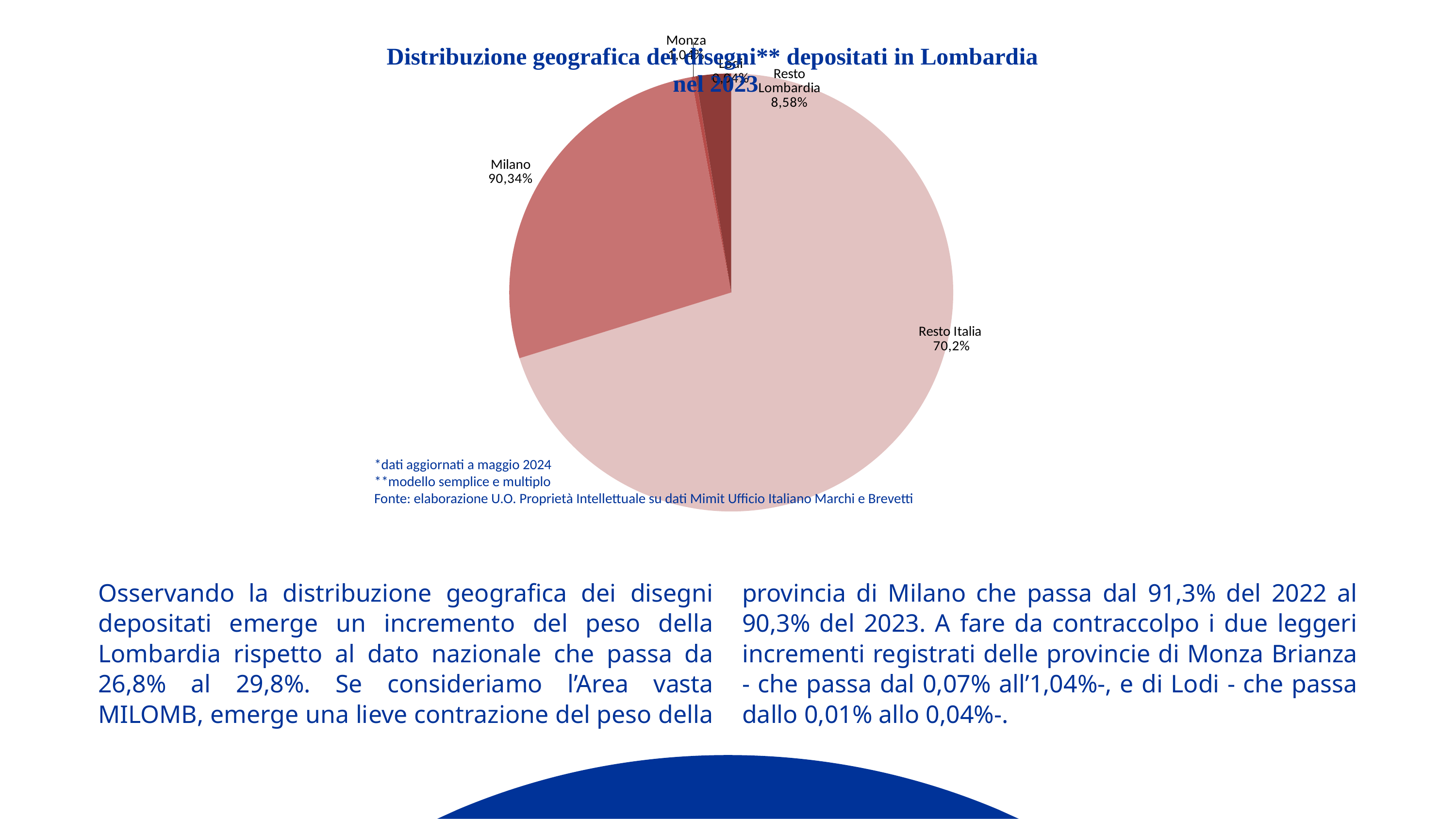
What is the title of the chart? Distribuzione geografica dei disegni** depositati in Lombardia nel 2023 Which has the larger value, Resto Italia or Resto Lombardia? Resto Italia What is the value shown for Resto Lombardia? 8,58% What is the difference between the values for Milano and Resto Lombardia? 81,76% What is the difference between the values for Resto Italia and Resto Lombardia? 61,62% What is the value shown for Resto Italia? 70,2% Which has the larger value, Milano or Resto Lombardia? Milano According to the note below the chart, what is the source of the data? Elaborazione U.O. Proprietà Intellettuale su dati Mimit Ufficio Italiano Marchi e Brevetti What is the value shown for Milano? 90,34% How many slices are labelled in the pie chart? 5 What kind of chart is shown on the slide? Pie chart